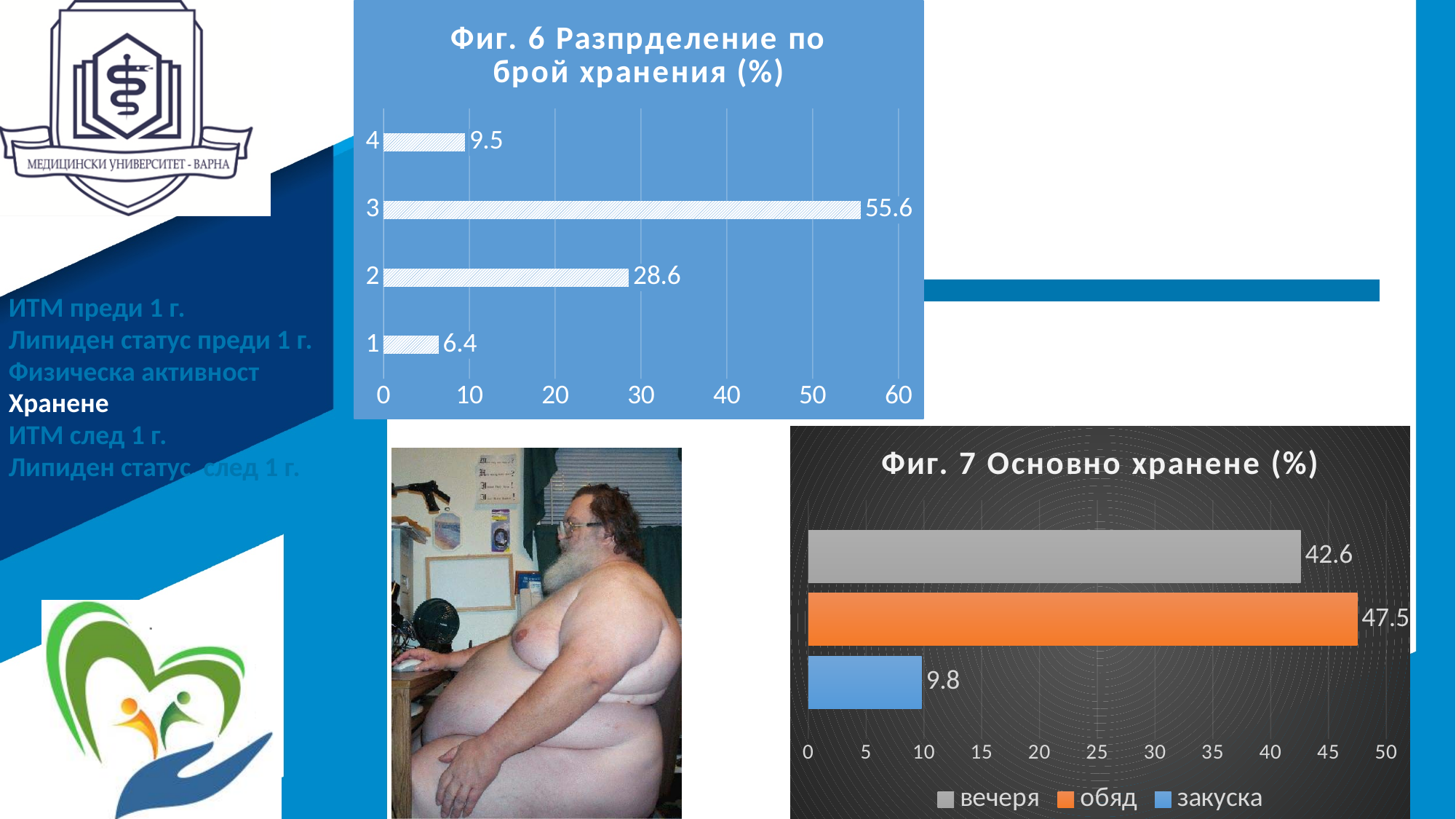
In the chart 'Фиг. 6 Разпрделение по брой хранения (%)', which category has the lowest value? 1 In the chart 'Фиг. 6 Разпрделение по брой хранения (%)', which category has the highest value? 3 What kind of chart is 'Фиг. 6 Разпрделение по брой хранения (%)'? bar chart In the chart 'Фиг. 6 Разпрделение по брой хранения (%)', how many categories are shown? 4 In the chart 'Фиг. 7 Основно хранене (%)', which is larger, вечеря or обяд? обяд In the chart 'Фиг. 6 Разпрделение по брой хранения (%)', what is the value for category 3? 55.6 In the chart 'Фиг. 7 Основно хранене (%)', what is the value for обяд? 47.5 In the chart 'Фиг. 7 Основно хранене (%)', what is the difference between the values for обяд and закуска? 37.7 In the chart 'Фиг. 6 Разпрделение по брой хранения (%)', what is the difference between the values for category 3 and category 2? 27.0 In the chart 'Фиг. 7 Основно хранене (%)', what is the value for закуска? 9.8 In the chart 'Фиг. 6 Разпрделение по брой хранения (%)', what is the value for category 1? 6.4 How many series does the legend of the chart 'Фиг. 7 Основно хранене (%)' list? 3